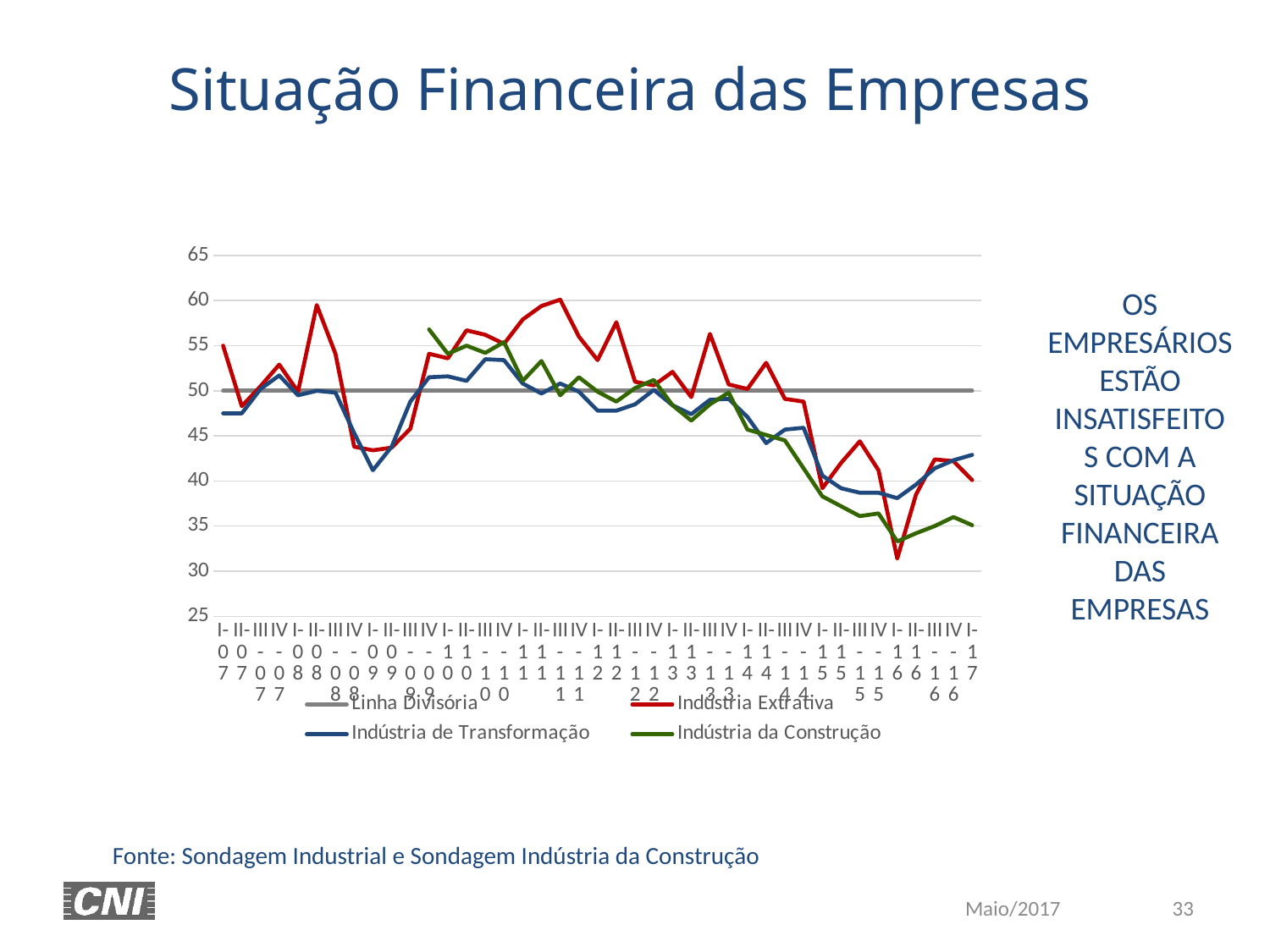
Is the value for Indústria da Construção at the last point (I-17) greater or less than 40? less At the last point on the x axis (I-17), which is larger: Indústria de Transformação or Indústria da Construção? Indústria de Transformação Which series is drawn in red on the chart? Indústria Extrativa How many series does the chart legend list? 4 What is the highest value shown on the vertical axis? 65 What is the title of the slide containing the chart? Situação Financeira das Empresas At what value does the Linha Divisória run across the chart? 50 Do the three industry series generally rise or fall between 2013 and 2016? fall Is the value for Indústria Extrativa at the last point (I-17) greater or less than 45? less Are the three industry series above or below the Linha Divisória at the end of the chart? below Which series reaches the highest value anywhere on the chart? Indústria Extrativa What kind of chart is shown on the slide? Line chart